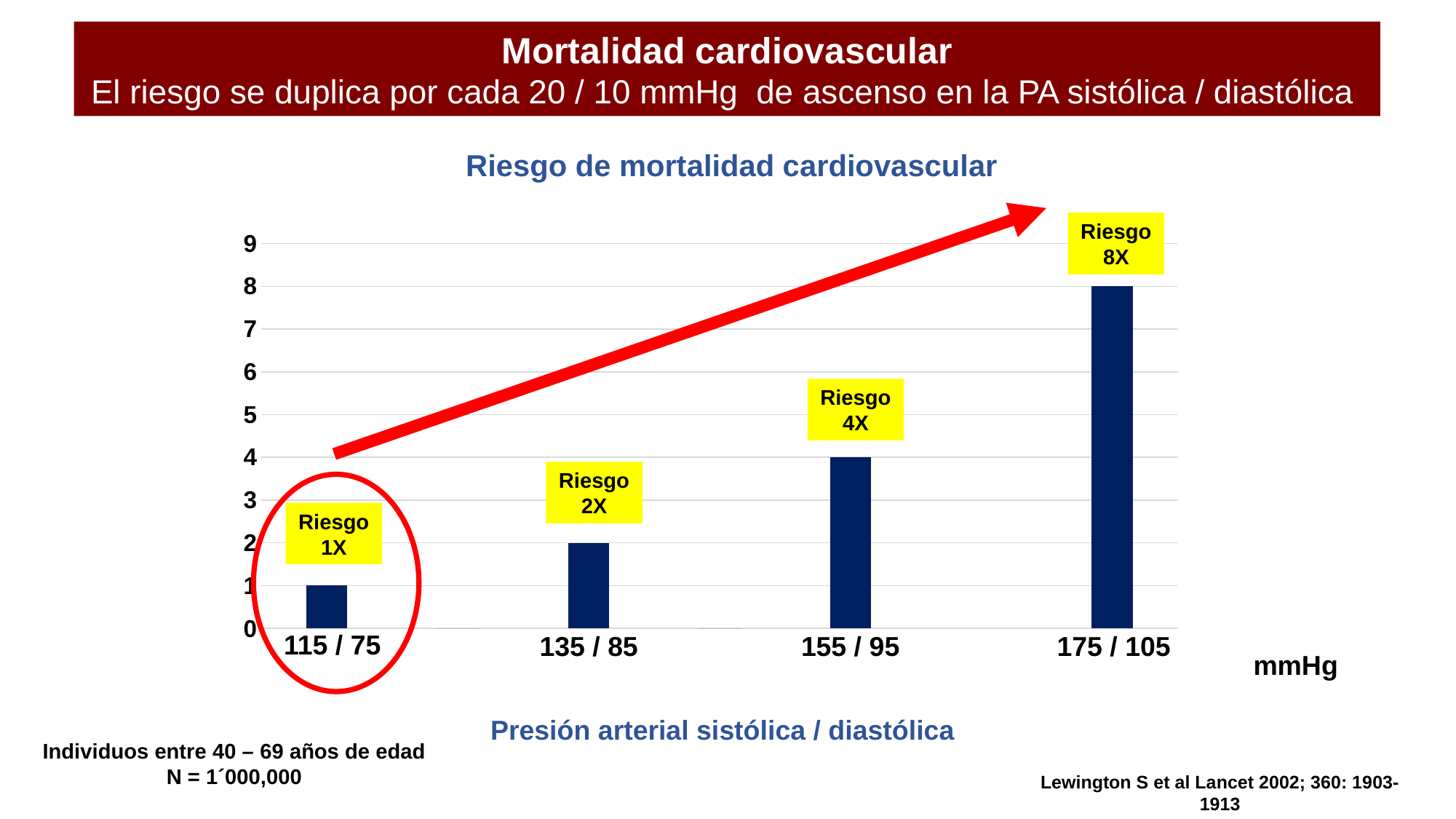
What is the risk label shown for the 175 / 105 mmHg bar? Riesgo 8X What is the difference between the risk value for 175 / 105 and the risk value for 155 / 95? 4 What type of chart is shown on the slide? Bar chart What is the risk label shown for the 135 / 85 mmHg bar? Riesgo 2X Which blood pressure category has the lowest cardiovascular mortality risk? 115 / 75 Do the risk values rise or fall as blood pressure increases along the x axis? Rise How many blood pressure categories are plotted on the x axis? 4 Which blood pressure category has the highest cardiovascular mortality risk? 175 / 105 Which has a higher risk value, 135 / 85 or 155 / 95? 155 / 95 What is the risk label shown for the 115 / 75 mmHg bar? Riesgo 1X What is the risk label shown for the 155 / 95 mmHg bar? Riesgo 4X What is the title of the chart? Riesgo de mortalidad cardiovascular